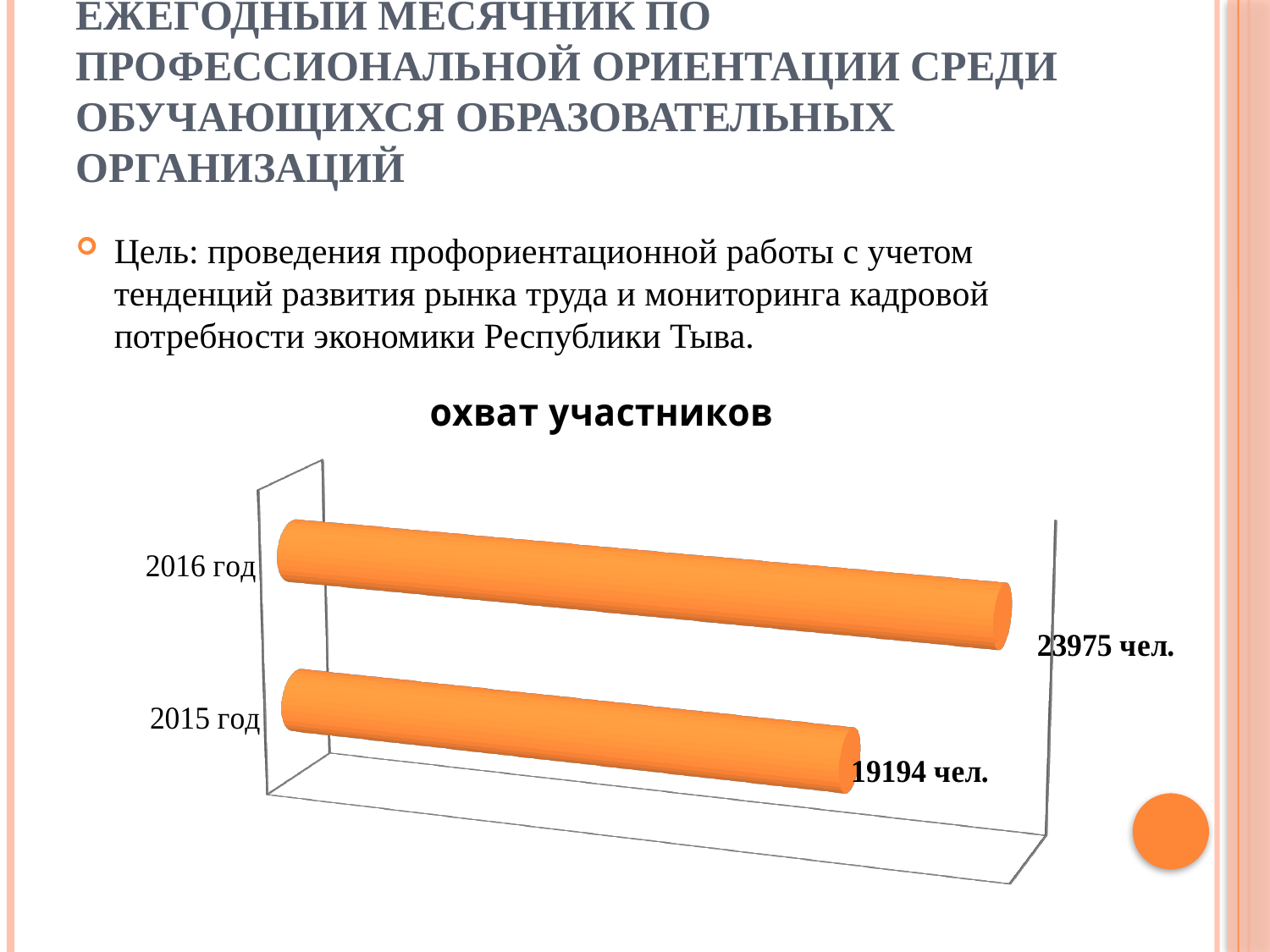
What is the title of the chart? охват участников How many categories are shown in the chart? 2 What colour are the bars in the chart? Orange What is the value for 2015 год in the chart? 19194 чел. What is the value for 2016 год in the chart? 23975 чел. Which year has the lowest value in the chart? 2015 год What is the difference between the values for 2016 год and 2015 год? 4781 чел. Which is larger, the value for 2016 год or the value for 2015 год? 2016 год Did the number of participants rise or fall from 2015 год to 2016 год? Rise What kind of chart is shown on the slide? Bar chart Which year has the highest value in the chart? 2016 год